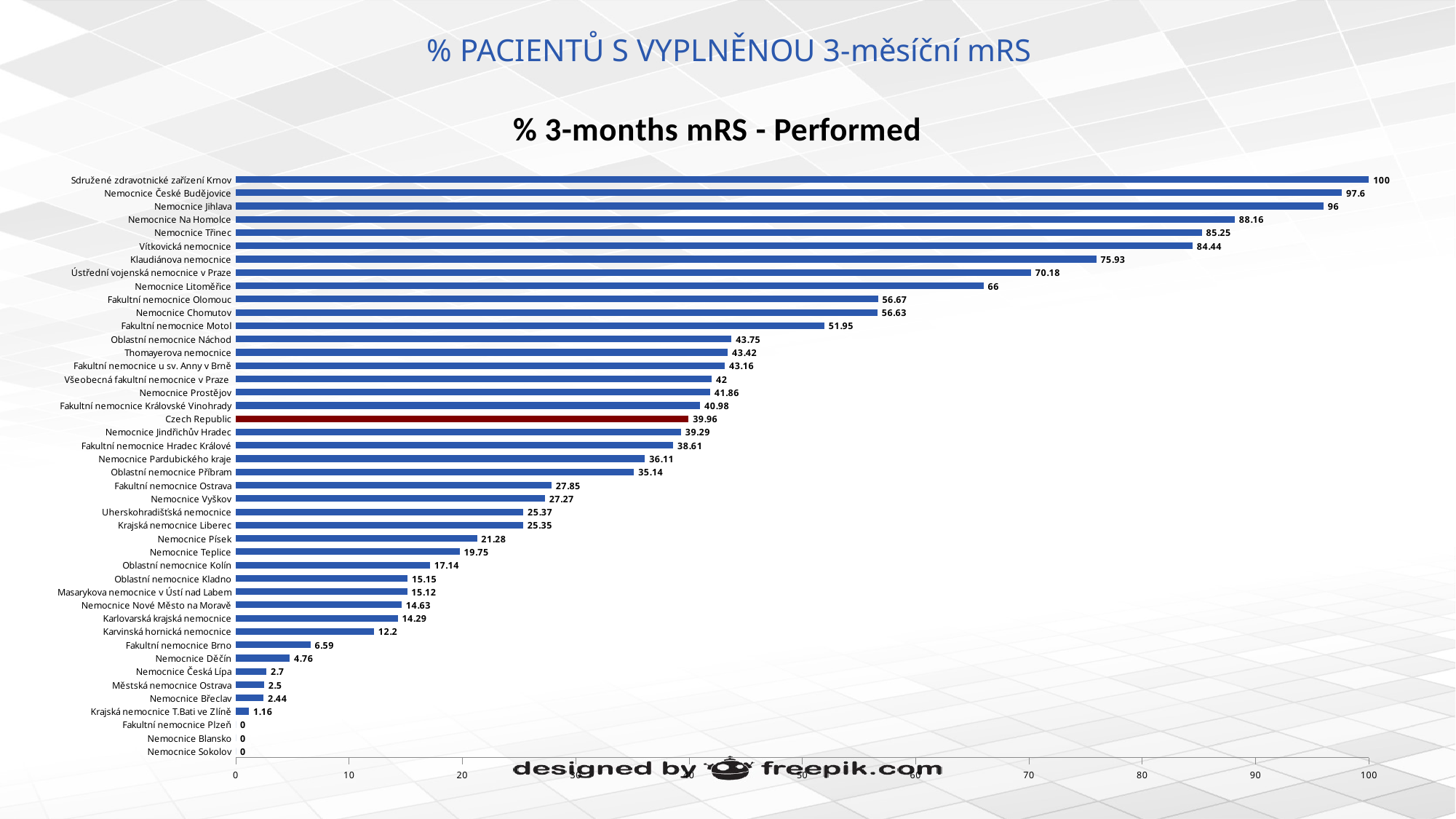
How many categories are shown in the chart? 44 What is the difference between the values for Nemocnice Jihlava and Nemocnice Na Homolce? 7.84 Which is larger, the value for Nemocnice Teplice or the value for Oblastní nemocnice Kolín? Nemocnice Teplice What is the value for Czech Republic? 39.96 Which bar is shown in a different colour (dark red) from the others? Czech Republic Which is larger, the value for Fakultní nemocnice Ostrava or the value for Oblastní nemocnice Příbram? Oblastní nemocnice Příbram What is the value for Nemocnice Písek? 21.28 What is the value for Fakultní nemocnice Motol? 51.95 What is the value for Fakultní nemocnice Brno? 6.59 Which category has the highest value? Sdružené zdravotnické zařízení Krnov What is the difference between the values for Klaudiánova nemocnice and Nemocnice Litoměřice? 9.93 What kind of chart is shown on the slide? Bar chart